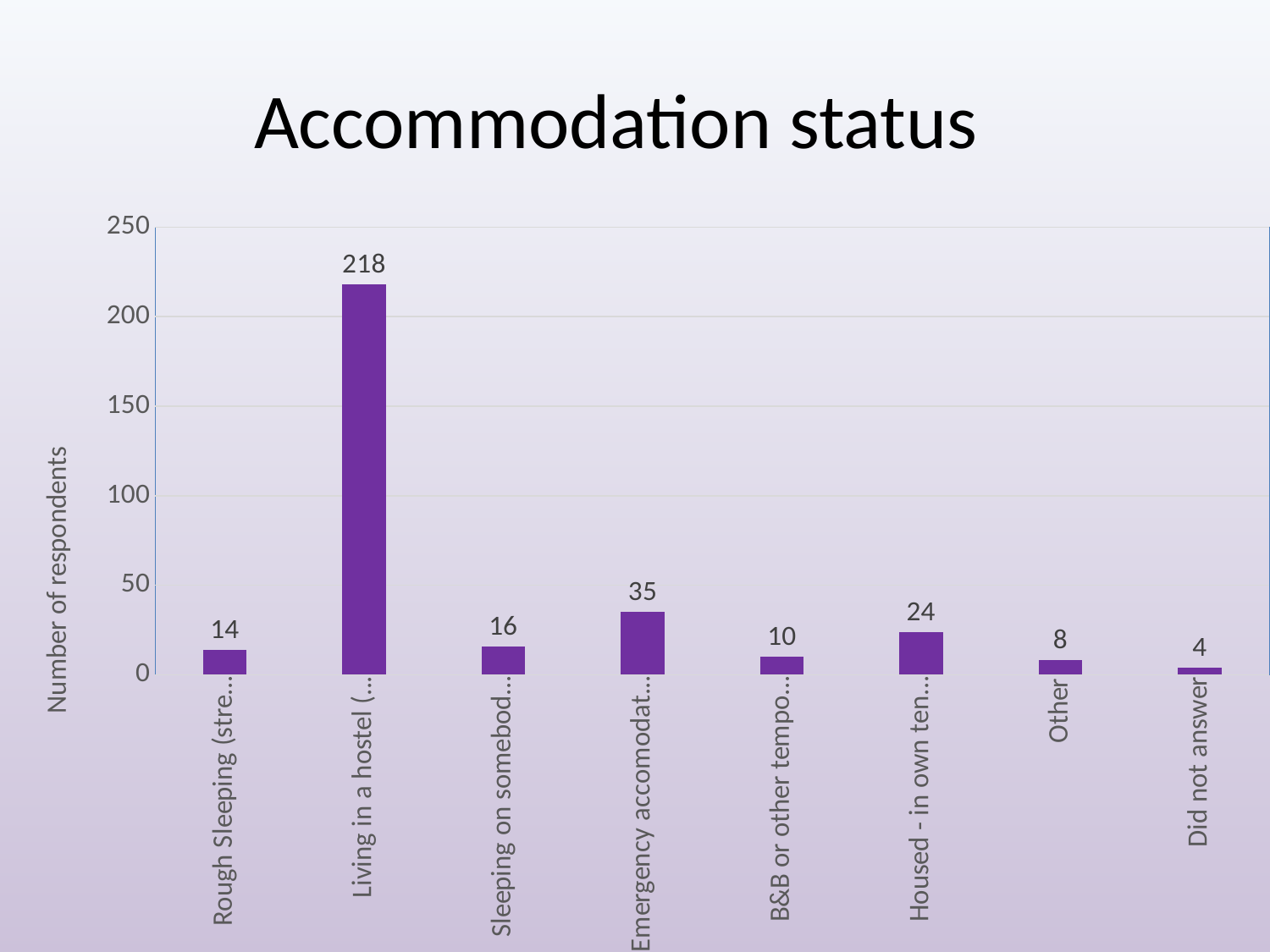
Which category has the highest number of respondents? Living in a hostel Which category has the lowest number of respondents? Did not answer What is the value for the 'Emergency accomodat...' bar? 35 Is the value for 'Rough Sleeping' greater or less than 50? less What kind of chart is shown on the slide? bar chart Which is larger: the value for 'Housed - in own ten...' or the value for 'Sleeping on somebod...'? Housed - in own ten... What is the difference between the 'Living in a hostel' value and the 'Emergency accomodat...' value? 183 What is the label of the vertical axis? Number of respondents What is the value for 'Living in a hostel' in the Accommodation status chart? 218 What is the value for 'Other'? 8 How many categories are shown on the x axis? 8 How many respondents are shown for 'Did not answer'? 4